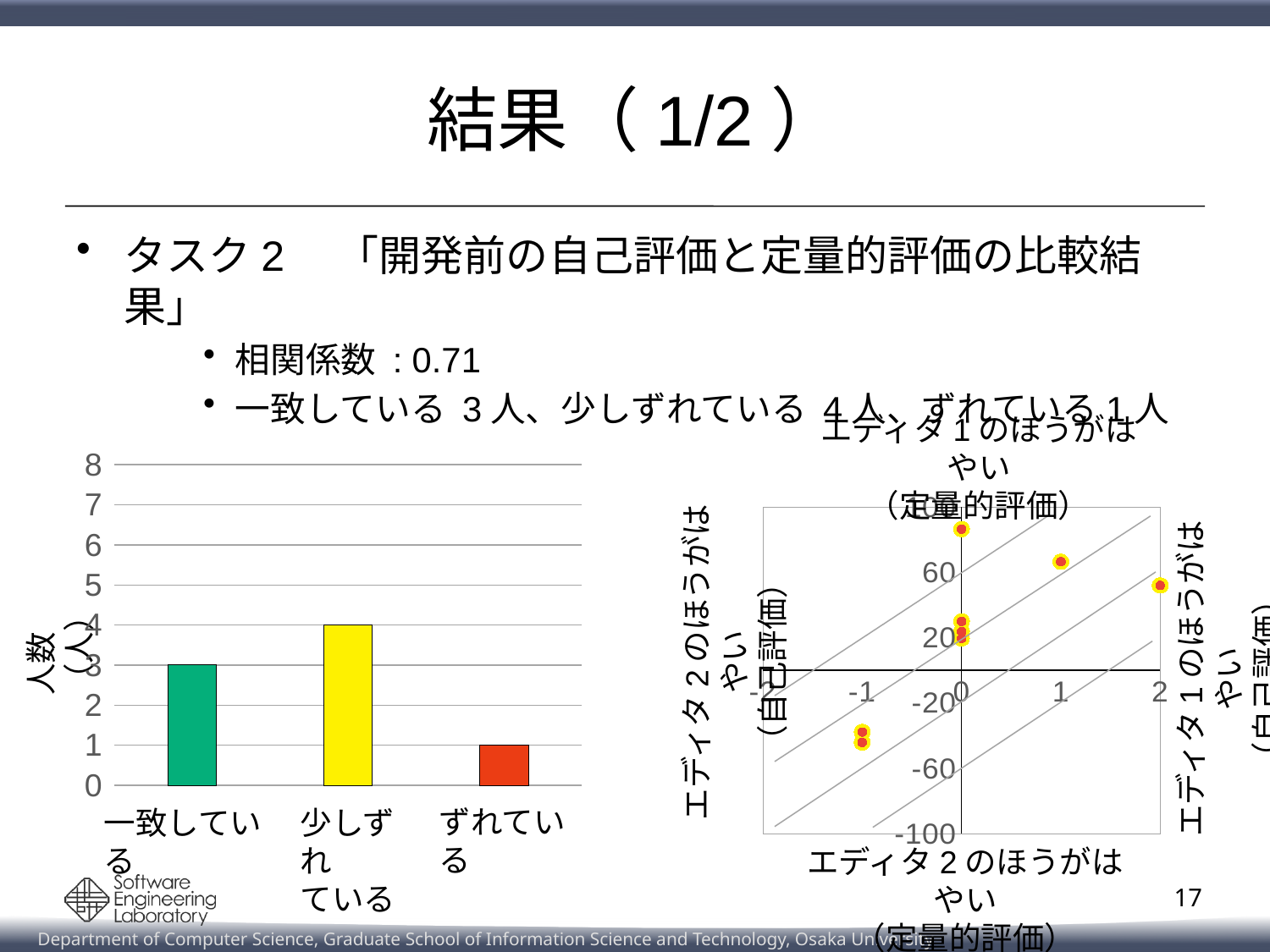
In the bar chart on the left, what is the value for ずれている? 1 How many categories does the bar chart on the left show? 3 In the bar chart on the left, what is the value for 一致している? 3 In the bar chart on the left, what is the difference between the values for 少しずれている and ずれている? 3 What kind of chart is the chart on the left of the slide? bar chart In the bar chart on the left, which category has the lowest value? ずれている In the scatter chart on the right, is the y value of the point at x = 2 greater or less than 20? greater In the bar chart on the left, what is the value for 少しずれている? 4 In the bar chart on the left, which category has the highest value? 少しずれている What kind of chart is the chart on the right of the slide? scatter chart What is the label of the vertical axis of the bar chart on the left? 人数（人） In the bar chart on the left, which is larger: the value for 一致している or the value for ずれている? 一致している